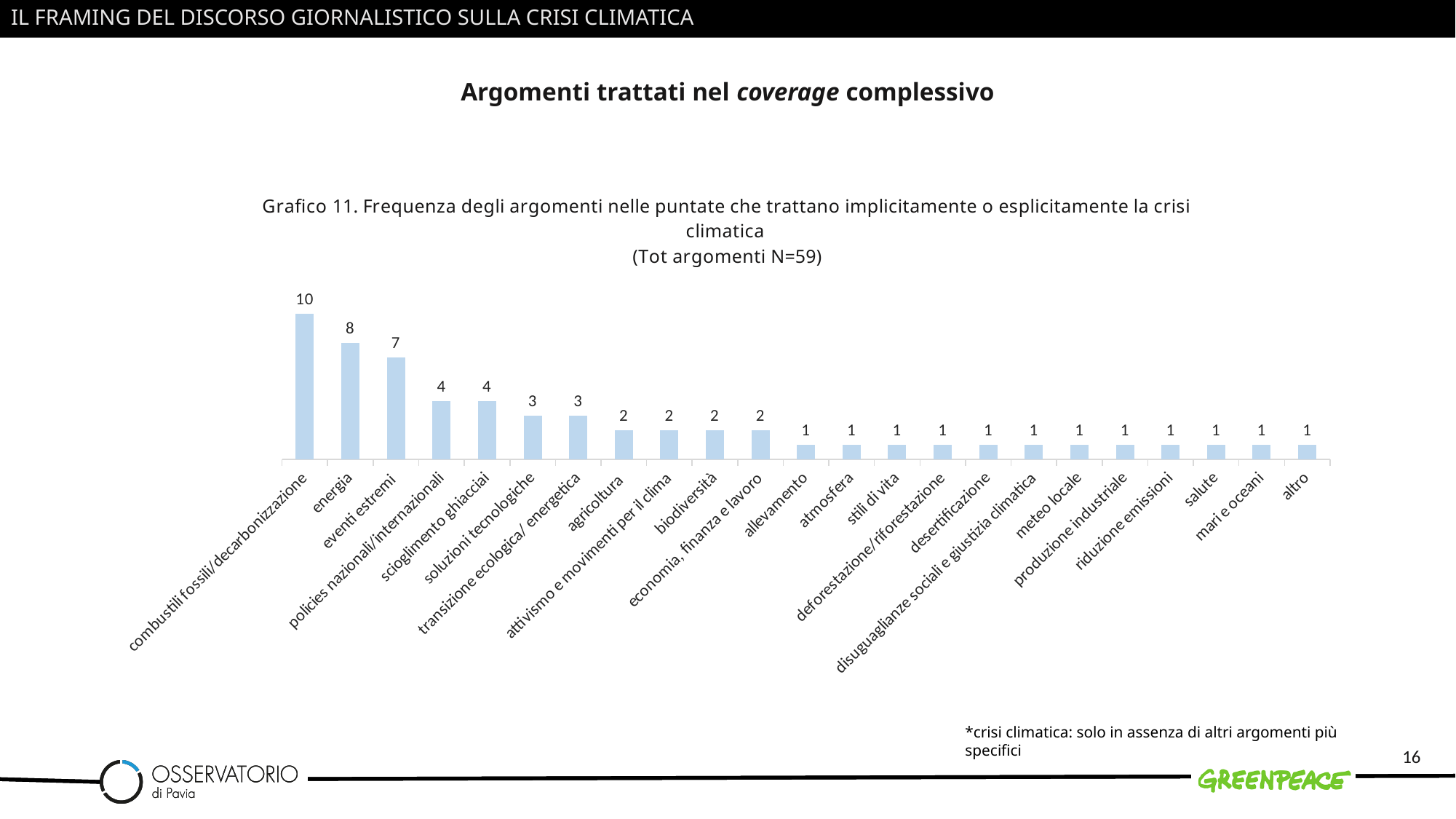
What is the value for eventi estremi? 7 What is the value for salute? 1 What kind of chart is shown on the slide? bar chart What total number of argomenti (N) is stated in the chart title? 59 Which category has the highest value? combustili fossili/decarbonizzazione What is the value for combustibili fossili/decarbonizzazione? 10 Which is larger, the value for energia or the value for policies nazionali/internazionali? energia What is the value for biodiversità? 2 What is the value for scioglimento ghiacciai? 4 What is the difference between the values for energia and soluzioni tecnologiche? 5 Do the values rise or fall from left to right along the x axis? fall How many categories are plotted in the chart? 23